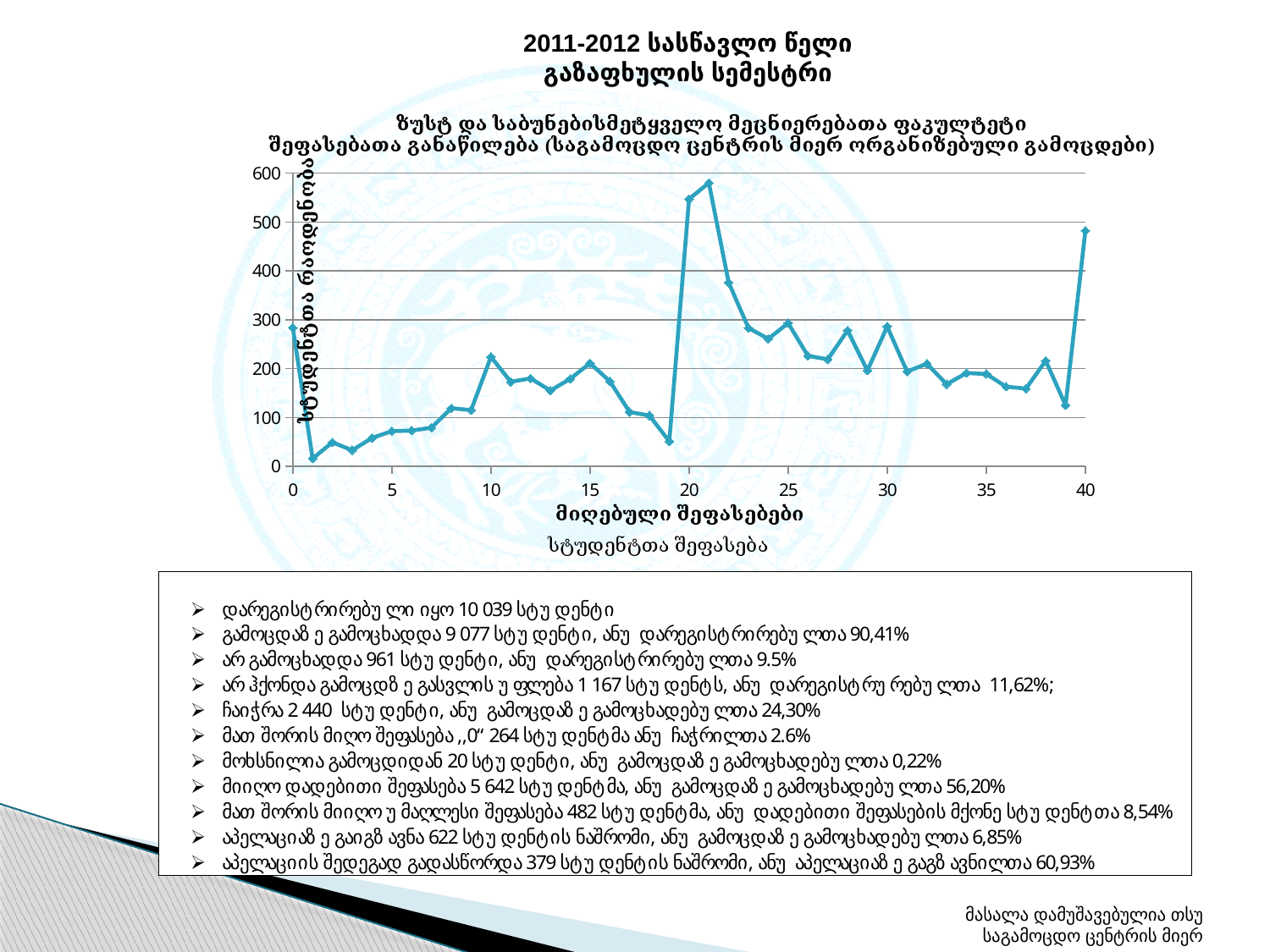
Do the values rise or fall along the x axis between x = 21 and x = 25? fall Is the value at x = 21 greater or less than 500? greater Which is larger: the value at x = 21 or the value at x = 40? x = 21 Is the value at x = 19 greater or less than 100? less Is the value at x = 40 greater or less than 400? greater At which x-axis value (score) does the line reach its lowest point? 1 At which x-axis value (score) does the line reach its highest point? 21 What is the label on the x axis of the chart? მიღებული შეფასებები What kind of chart is shown on the slide? line chart